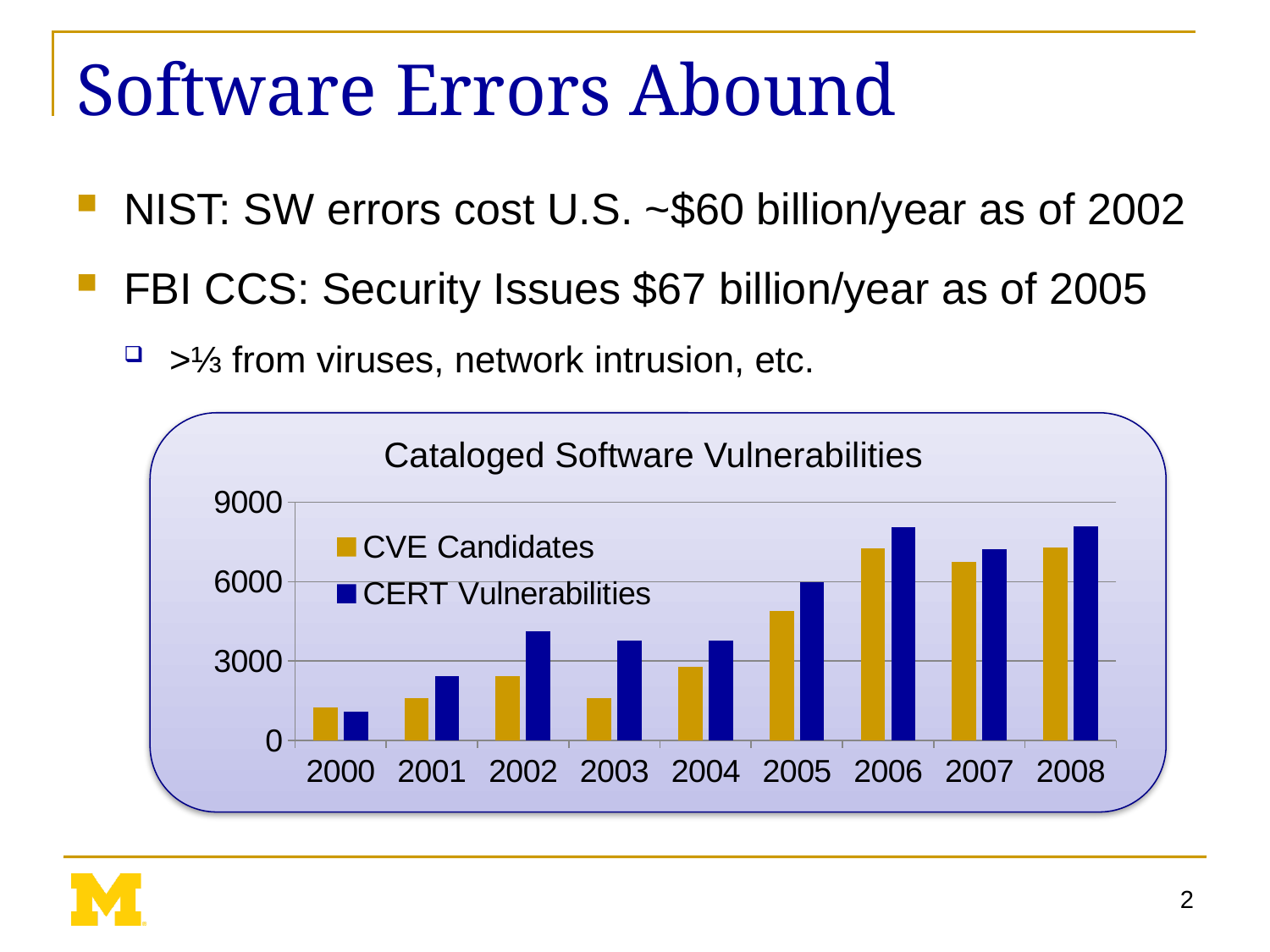
Do the CERT Vulnerabilities values generally rise or fall from 2000 to 2008? Rise How many series does the chart's legend list? 2 What is the title of the chart? Cataloged Software Vulnerabilities Which year has the lowest value for CERT Vulnerabilities? 2000 Is the value for CERT Vulnerabilities in 2006 greater or less than 6000? greater What kind of chart is shown on the slide? Bar chart Is the value for CERT Vulnerabilities in 2002 greater or less than 3000? greater In 2002, which is larger: CVE Candidates or CERT Vulnerabilities? CERT Vulnerabilities Is the value for CVE Candidates in 2000 greater or less than 3000? less How many years are shown along the x axis of the chart? 9 Which series is drawn in blue in the chart? CERT Vulnerabilities